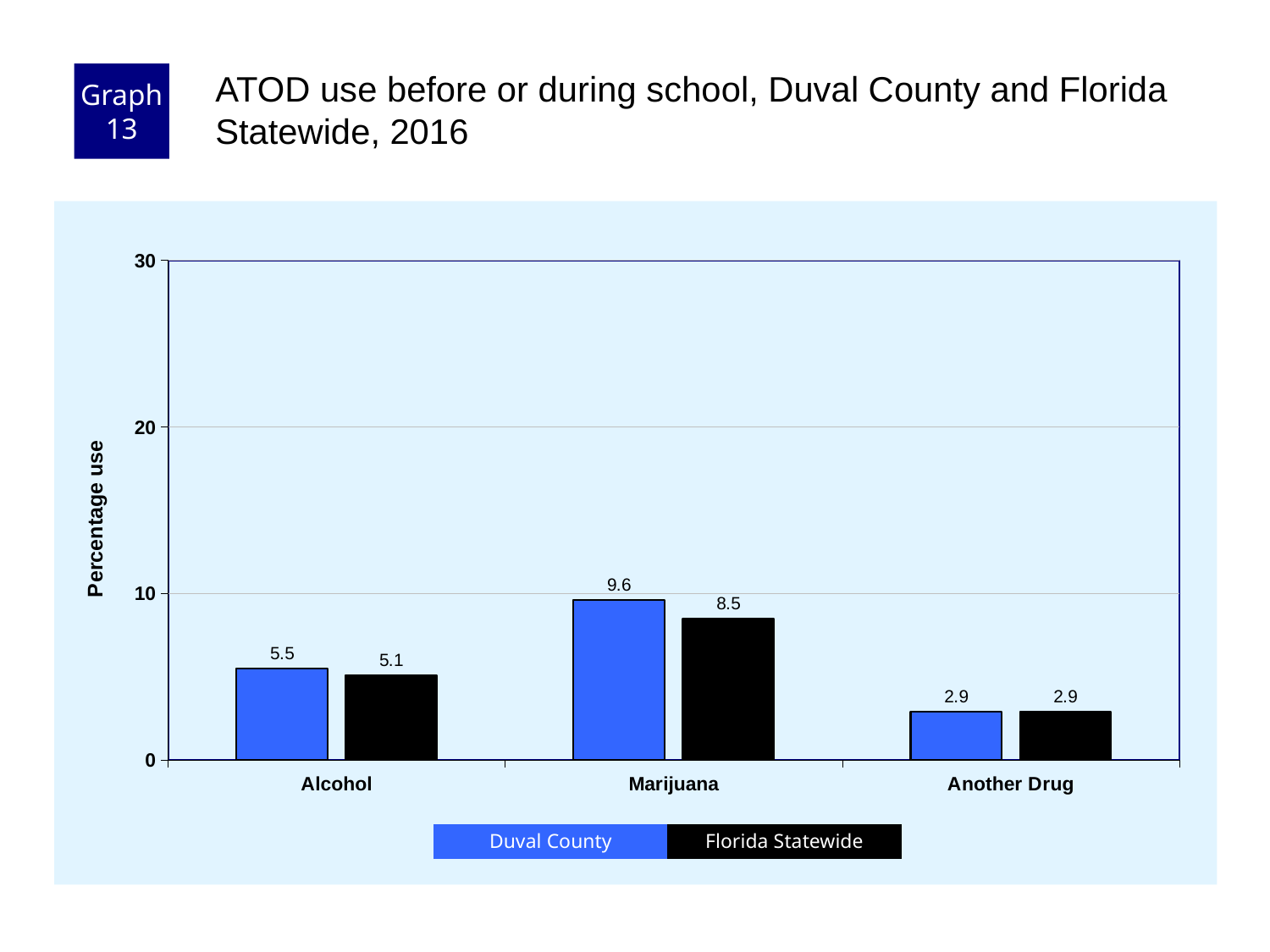
Which is larger for Alcohol, the Duval County value or the Florida Statewide value? Duval County What is the Duval County value for Marijuana? 9.6 Which category has the highest Duval County value? Marijuana How many series does the legend list? 2 What is the difference between the Duval County and Florida Statewide values for Marijuana? 1.1 What is the Florida Statewide value for Alcohol? 5.1 Which category has the lowest Florida Statewide value? Another Drug What is the difference between the Duval County values for Marijuana and Alcohol? 4.1 How many categories are shown on the x axis? 3 What kind of chart is shown on the slide? bar chart What is the Duval County value for Another Drug? 2.9 Is the Florida Statewide value for Marijuana greater or less than 10? less